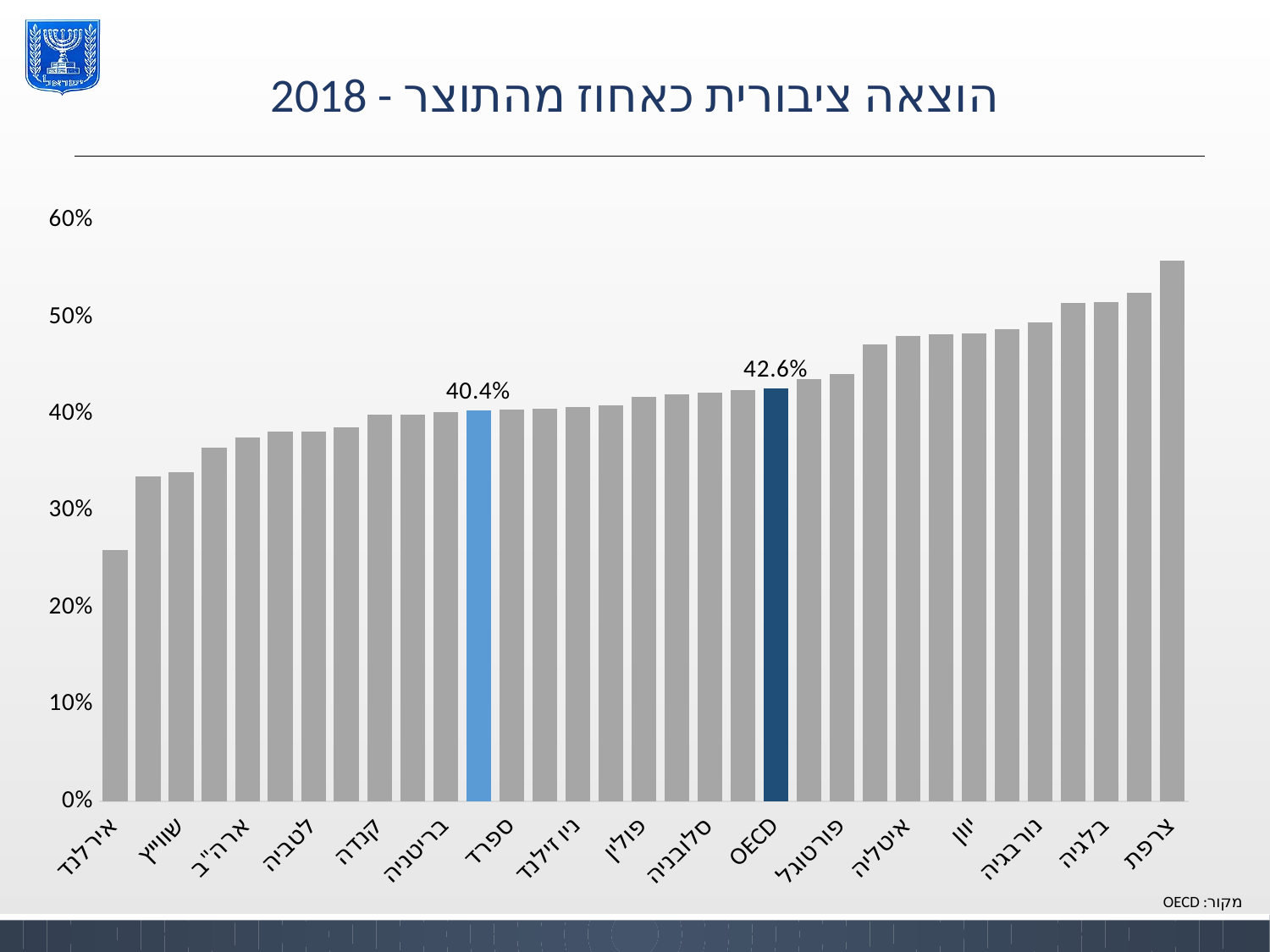
What is the value shown for OECD? 42.6% Is the value for איטליה greater or less than 50%? less Which is larger, the value for OECD or the value for ספרד? OECD What is the title of the chart? הוצאה ציבורית כאחוז מהתוצר - 2018 Is the value for צרפת greater or less than 50%? greater Do the values rise or fall from left to right along the x axis? rise What kind of chart is shown on the slide? bar chart Is the value for אירלנד greater or less than 30%? less Which country has the highest bar in the chart? צרפת Which country has the lowest bar in the chart? אירלנד